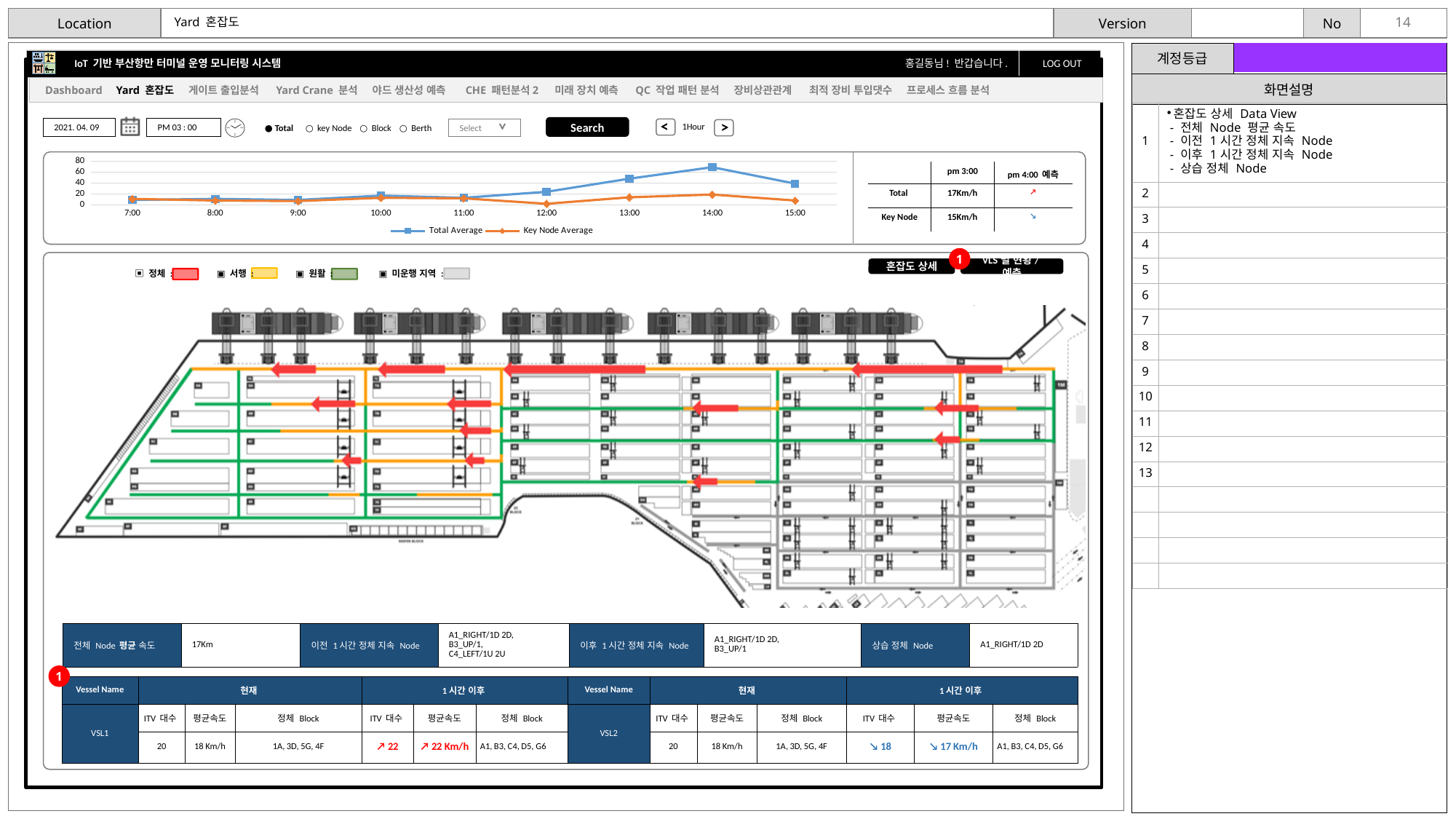
Does the Total Average series rise or fall between 14:00 and 15:00? fall How many time points are shown along the x axis of the line chart? 9 What colour is the Total Average line in the chart? blue Is the Key Node Average value at 14:00 greater or less than 40? less How many series does the legend of the line chart list? 2 Is the Total Average value at 14:00 greater or less than 40? greater At which time does the Total Average series reach its highest value? 14:00 Is the Total Average value at 8:00 greater or less than 40? less At which time does the Key Node Average series reach its highest value? 14:00 What kind of chart is shown at the top of the slide? line chart Does the Total Average series rise or fall between 12:00 and 14:00? rise At 14:00, which series has the larger value, Total Average or Key Node Average? Total Average